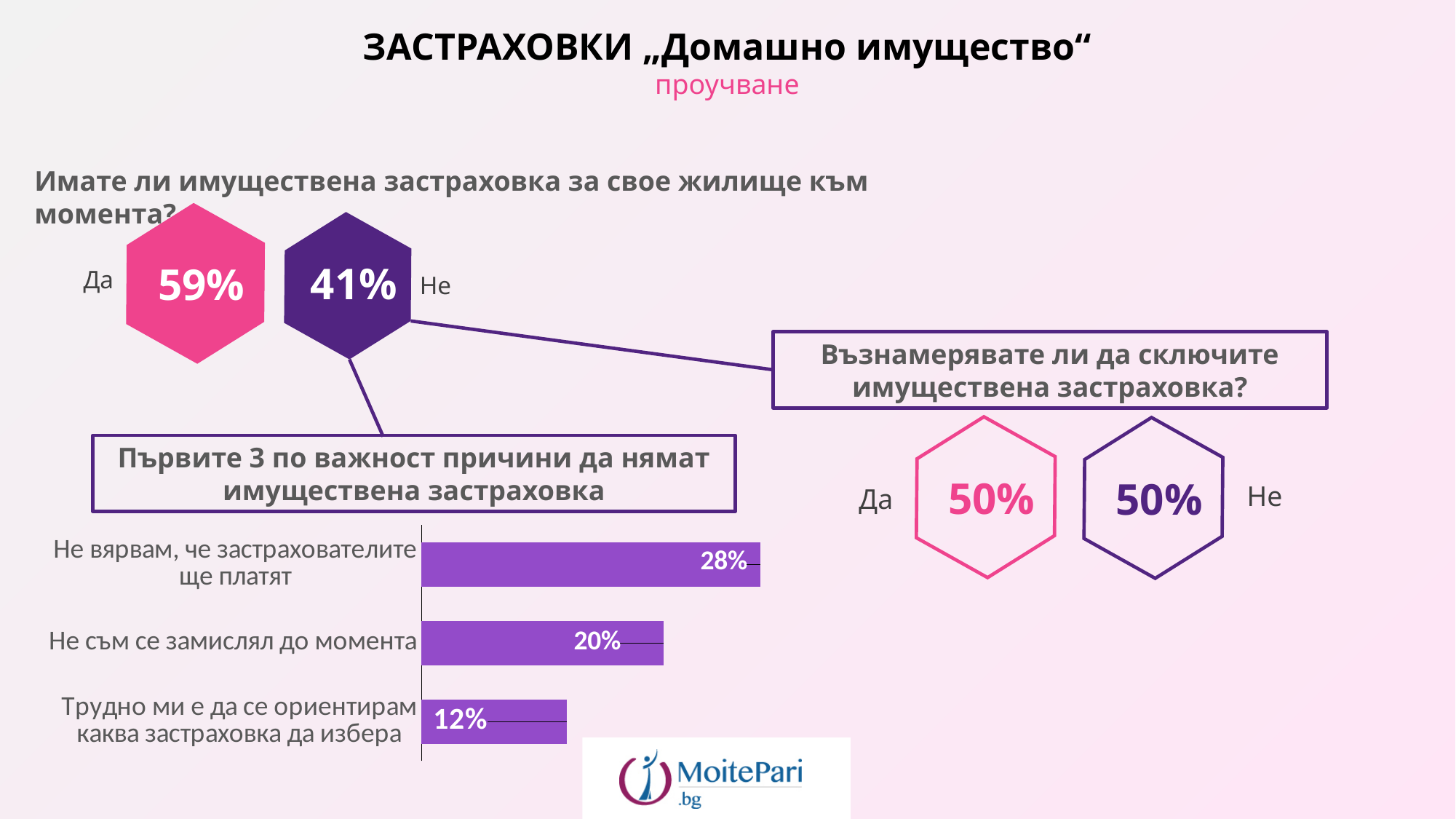
What type of chart is shown under the heading "Първите 3 по важност причини да нямат имуществена застраховка"? bar chart In the bar chart, what is the difference between the values for "Не вярвам, че застрахователите ще платят" and "Не съм се замислял до момента"? 8% What colour are the bars in the bar chart? purple In the bar chart, which is larger: the value for "Не съм се замислял до момента" or for "Трудно ми е да се ориентирам каква застраховка да избера"? Не съм се замислял до момента Which category in the bar chart has the highest value? Не вярвам, че застрахователите ще платят In the bar chart, what is the value for "Не съм се замислял до момента"? 20% Do the values in the bar chart increase or decrease from the top bar to the bottom bar? decrease How many categories does the bar chart show? 3 In the bar chart, what is the value for "Не вярвам, че застрахователите ще платят"? 28% In the bar chart, what is the difference between the values for "Не съм се замислял до момента" and "Трудно ми е да се ориентирам каква застраховка да избера"? 8% In the bar chart, what is the value for "Трудно ми е да се ориентирам каква застраховка да избера"? 12% Which category in the bar chart has the lowest value? Трудно ми е да се ориентирам каква застраховка да избера